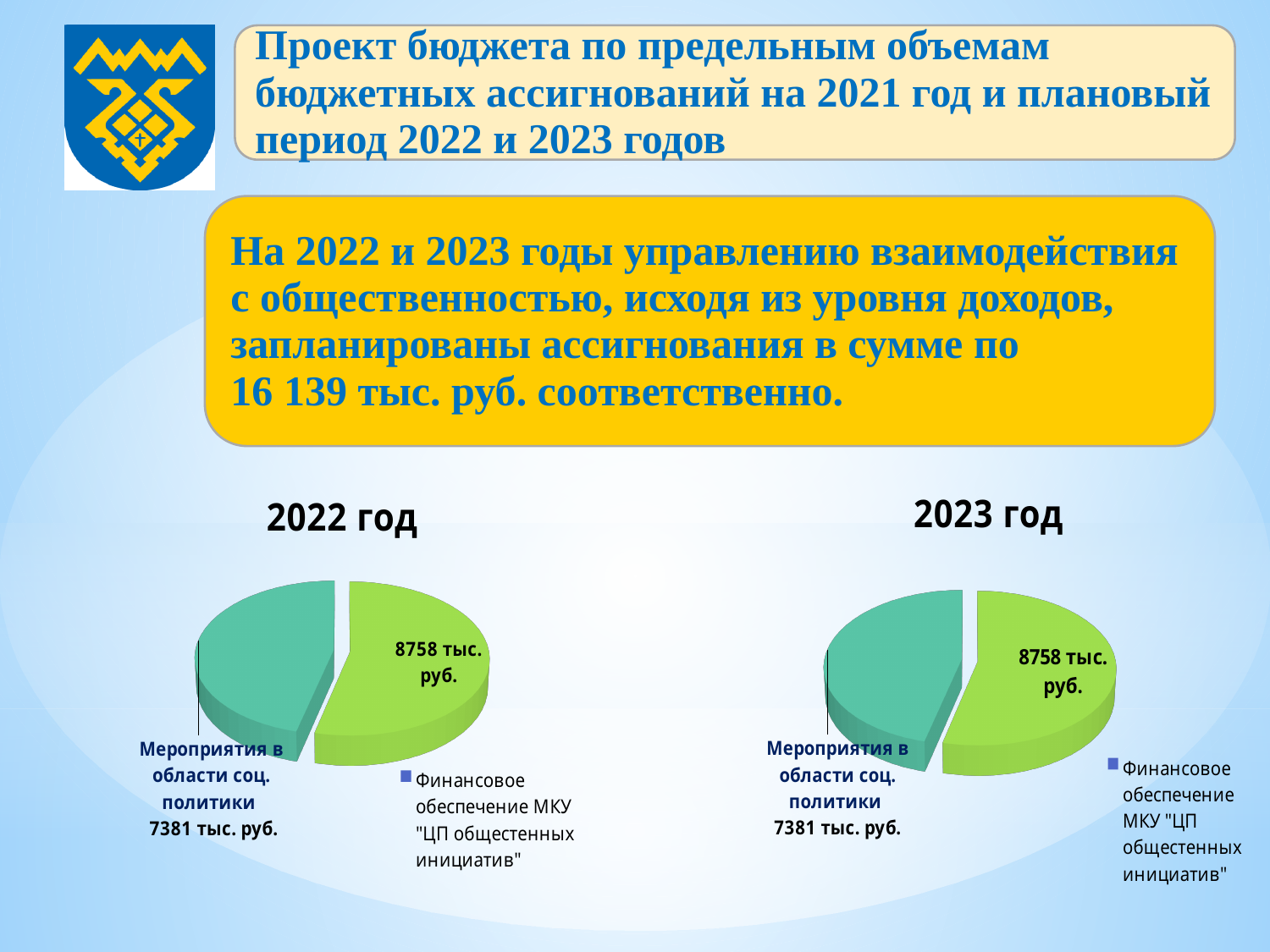
How many pie charts are shown on the slide? 2 In the "2022 год" chart, what is the value for "Мероприятия в области соц. политики"? 7381 тыс. руб. In the "2022 год" chart, which slice is the largest? Финансовое обеспечение МКУ "ЦП общестенных инициатив" In the "2023 год" chart, which slice is the smallest? Мероприятия в области соц. политики In the "2023 год" chart, what is the value for "Финансовое обеспечение МКУ "ЦП общестенных инициатив""? 8758 тыс. руб. In the "2023 год" chart, what is the total of the two slices? 16 139 тыс. руб. In the "2022 год" chart, what is the value for "Финансовое обеспечение МКУ "ЦП общестенных инициатив""? 8758 тыс. руб. In the "2023 год" chart, what is the value for "Мероприятия в области соц. политики"? 7381 тыс. руб. How many slices does the "2022 год" chart have? 2 In the "2022 год" chart, what is the difference between the two slices? 1377 тыс. руб. In the "2023 год" chart, which is larger: "Финансовое обеспечение МКУ "ЦП общестенных инициатив"" or "Мероприятия в области соц. политики"? Финансовое обеспечение МКУ "ЦП общестенных инициатив" What type of chart is the "2022 год" chart? pie chart